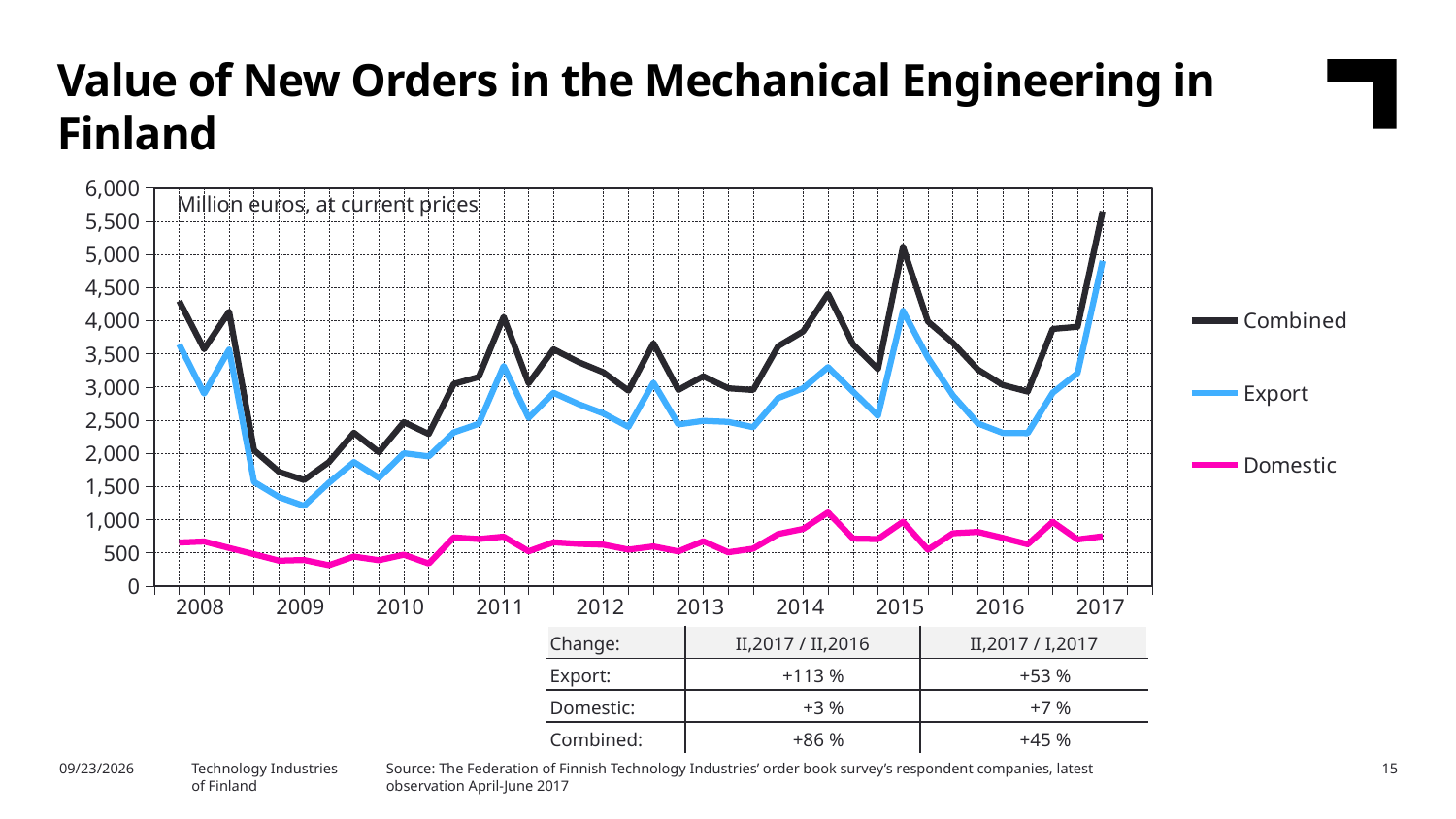
Does the Combined series rise or fall from its 2015 peak to 2016? fall Which series has the lowest values throughout the chart? Domestic Is the value of the Export series at the last point in 2017 greater or less than 4,500? greater Is the value of the Combined series at the last point in 2017 greater or less than 5,000? greater Is the lowest value of the Export series in 2009 greater or less than 1,500? less At the last point in 2017, which is larger, Export or Domestic? Export According to the change table below the chart, what is the Export change for II,2017 / II,2016? +113 % What kind of chart is shown on the slide? line chart Which series has the highest values throughout the chart? Combined How many series does the legend list? 3 How many years are labelled on the x axis? 10